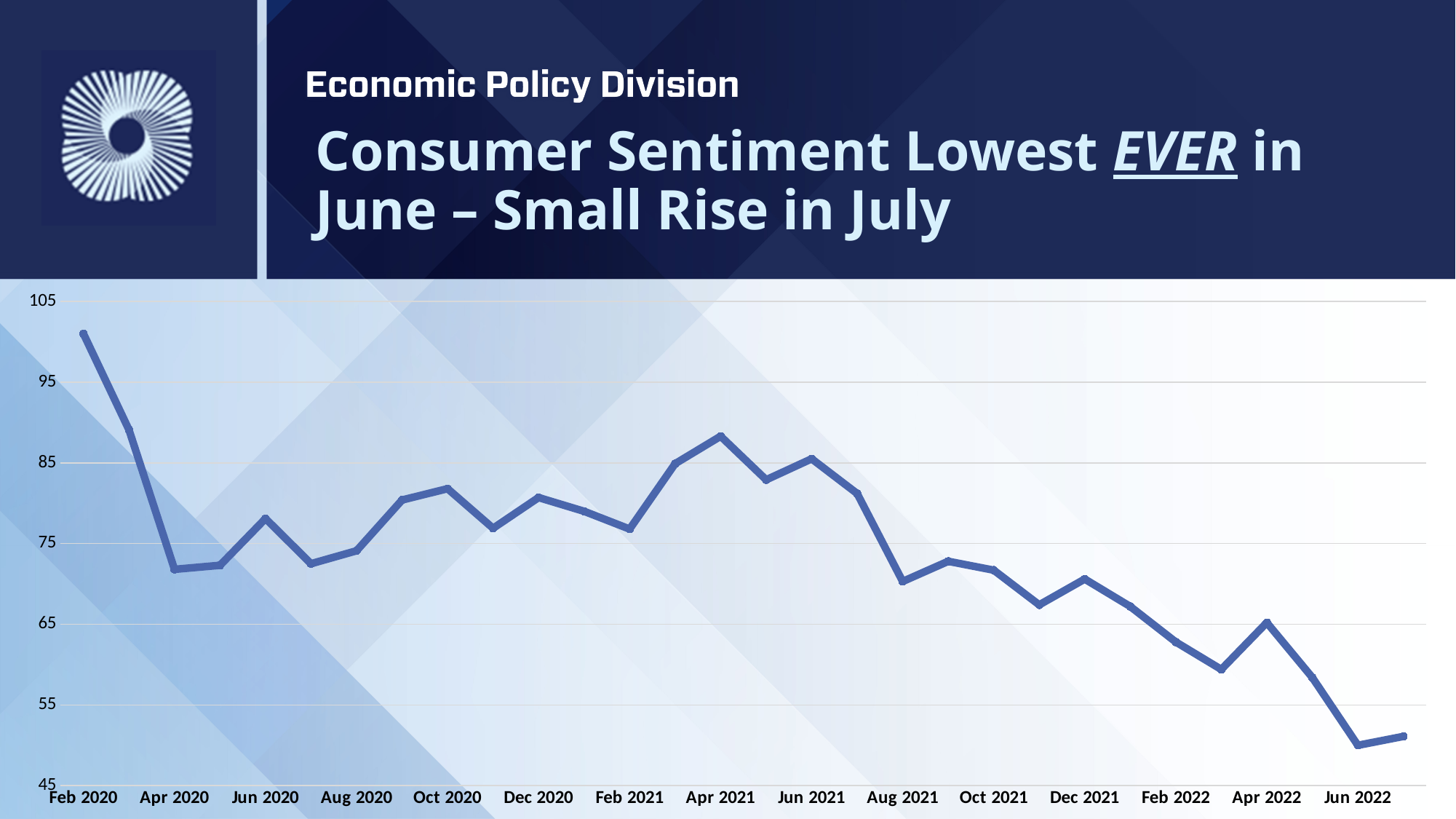
Is the value for Jun 2022 greater or less than 55? less Which month has the highest consumer sentiment value on the chart? Feb 2020 Which labelled month has the lowest consumer sentiment value on the chart? Jun 2022 How many month labels are shown on the x axis? 15 Is the value for Feb 2022 greater or less than 65? less Is the value for Apr 2021 greater or less than 85? greater What is the title of the slide containing the chart? Consumer Sentiment Lowest EVER in June – Small Rise in July Overall, do the values rise or fall from Feb 2020 to Jun 2022? fall What kind of chart is shown on the slide? line chart Which is larger, the value for Apr 2021 or the value for Apr 2022? Apr 2021